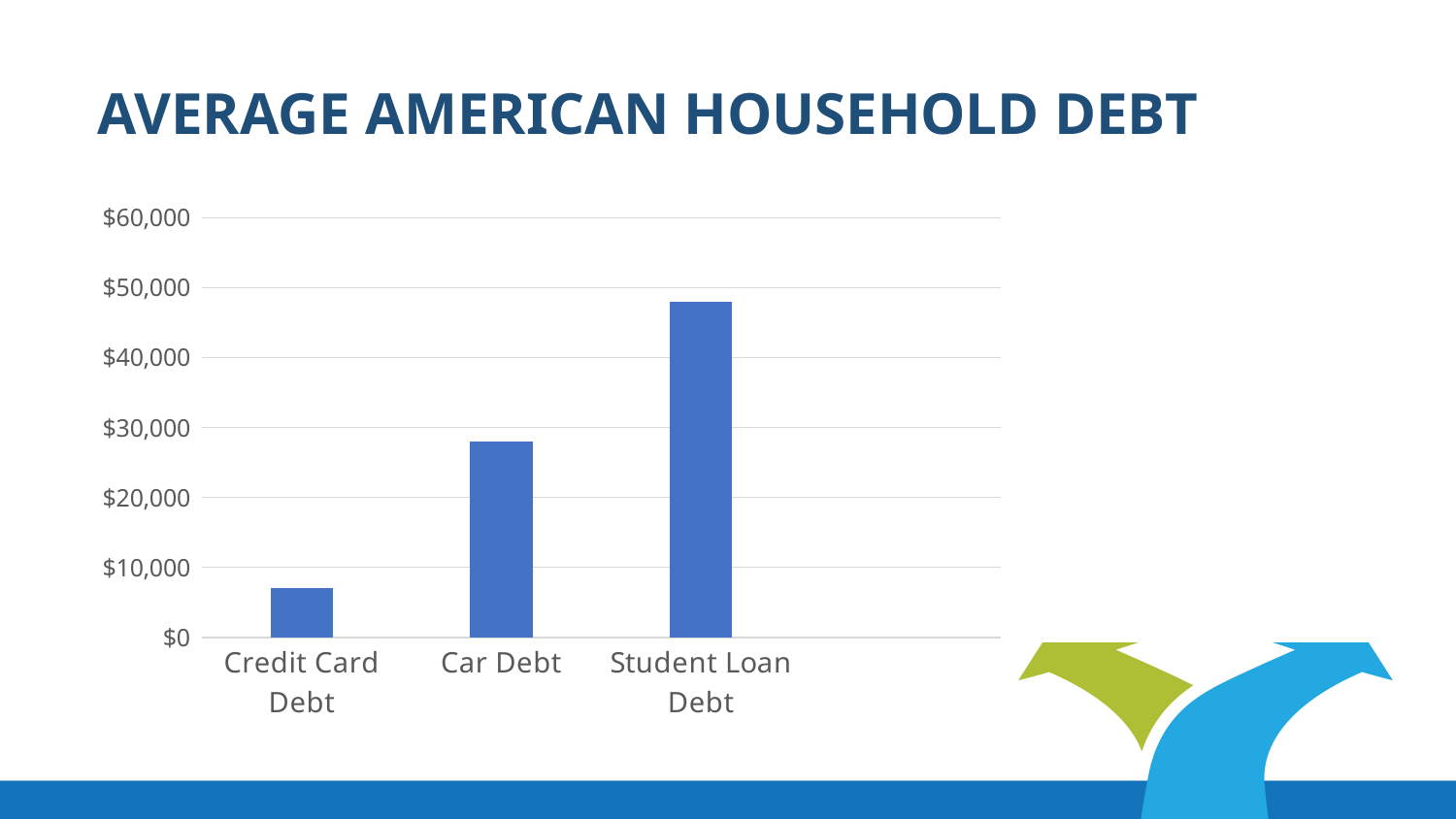
Which is larger, Car Debt or Credit Card Debt? Car Debt Which category has the lowest average debt? Credit Card Debt Is the value for Student Loan Debt greater or less than $50,000? less Is the value for Student Loan Debt greater or less than $40,000? greater Is the value for Credit Card Debt greater or less than $10,000? less Which is larger, Student Loan Debt or Car Debt? Student Loan Debt What kind of chart is shown on the slide? Bar chart Which category has the highest average debt? Student Loan Debt What is the title of the slide's chart? AVERAGE AMERICAN HOUSEHOLD DEBT Do the bar values rise or fall from left to right across the categories? Rise How many debt categories are plotted in the chart? 3